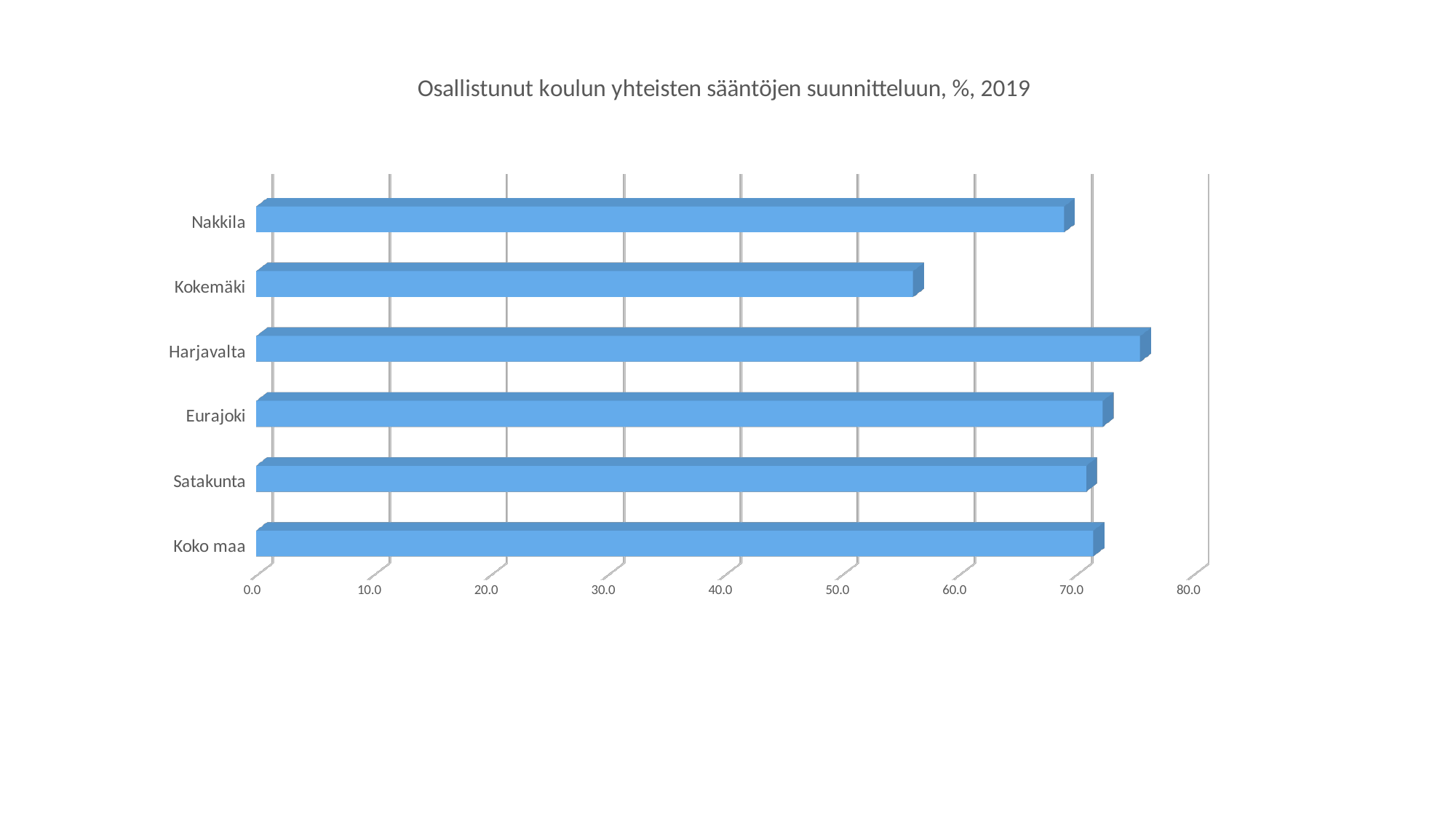
What kind of chart is shown on the slide? bar chart Is the value for Kokemäki greater or less than 60.0? less Which category has the highest value? Harjavalta Which has a larger value, Nakkila or Kokemäki? Nakkila Which category has the lowest value? Kokemäki Is the value for Harjavalta greater or less than 70.0? greater How many categories are plotted in the chart? 6 Is the value for Eurajoki greater or less than 70.0? greater What is the title of the chart? Osallistunut koulun yhteisten sääntöjen suunnitteluun, %, 2019 Which has a larger value, Harjavalta or Eurajoki? Harjavalta